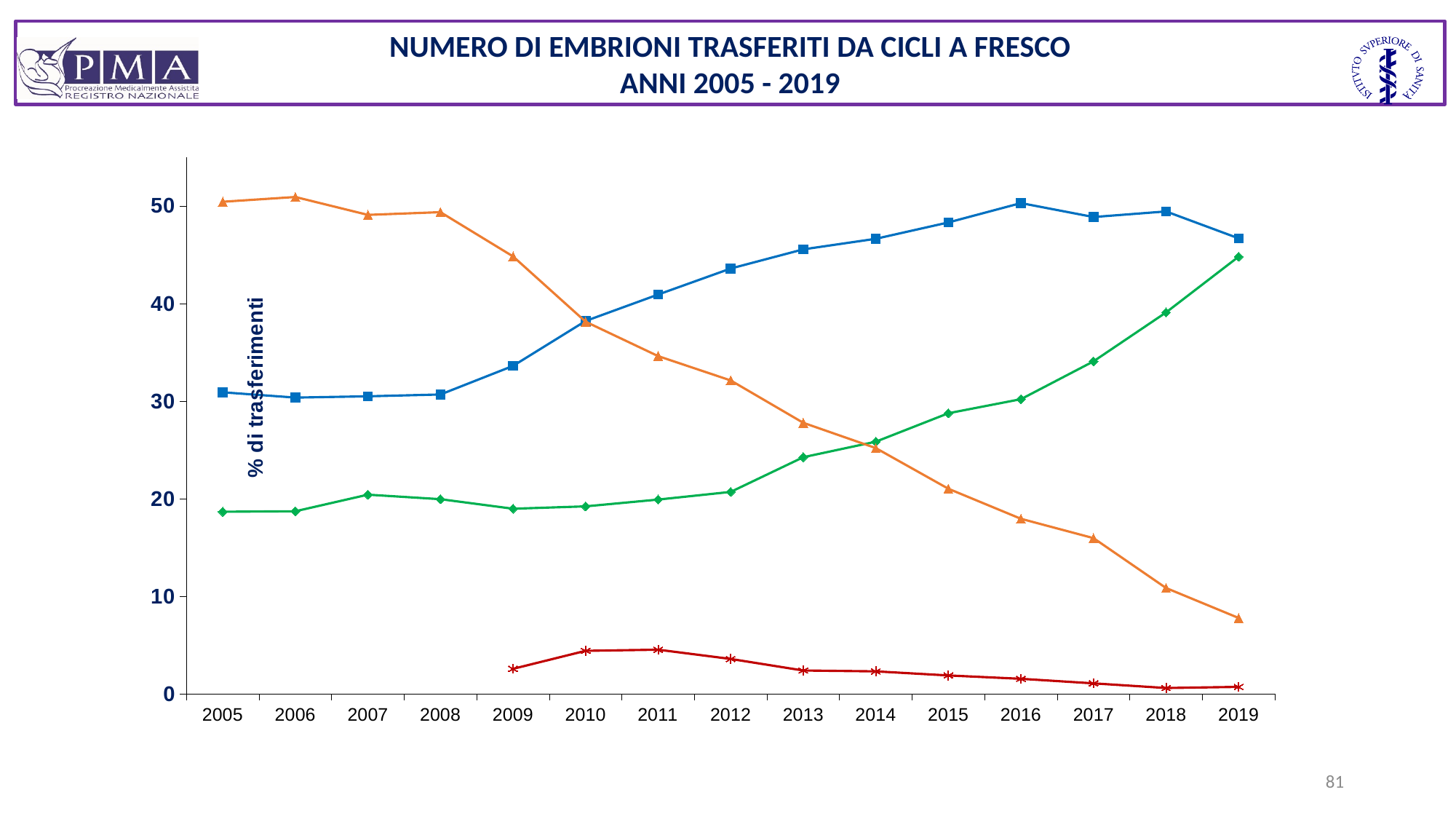
What kind of chart is shown on the slide? line chart What is the label on the vertical axis of the chart? % di trasferimenti How many years are shown along the x axis of the chart? 15 Does the orange line (triangle markers) rise or fall from 2005 to 2019? fall Is the value of the red line (asterisk markers) in 2011 greater or less than 10? less Does the green line (diamond markers) rise or fall from 2009 to 2019? rise Is the value of the green line (diamond markers) in 2005 greater or less than 20? less Is the value of the orange line (triangle markers) in 2019 greater or less than 10? less In 2019, which is larger: the green line (diamond markers) or the orange line (triangle markers)? green line What is the title of the chart on the slide? NUMERO DI EMBRIONI TRASFERITI DA CICLI A FRESCO ANNI 2005 - 2019